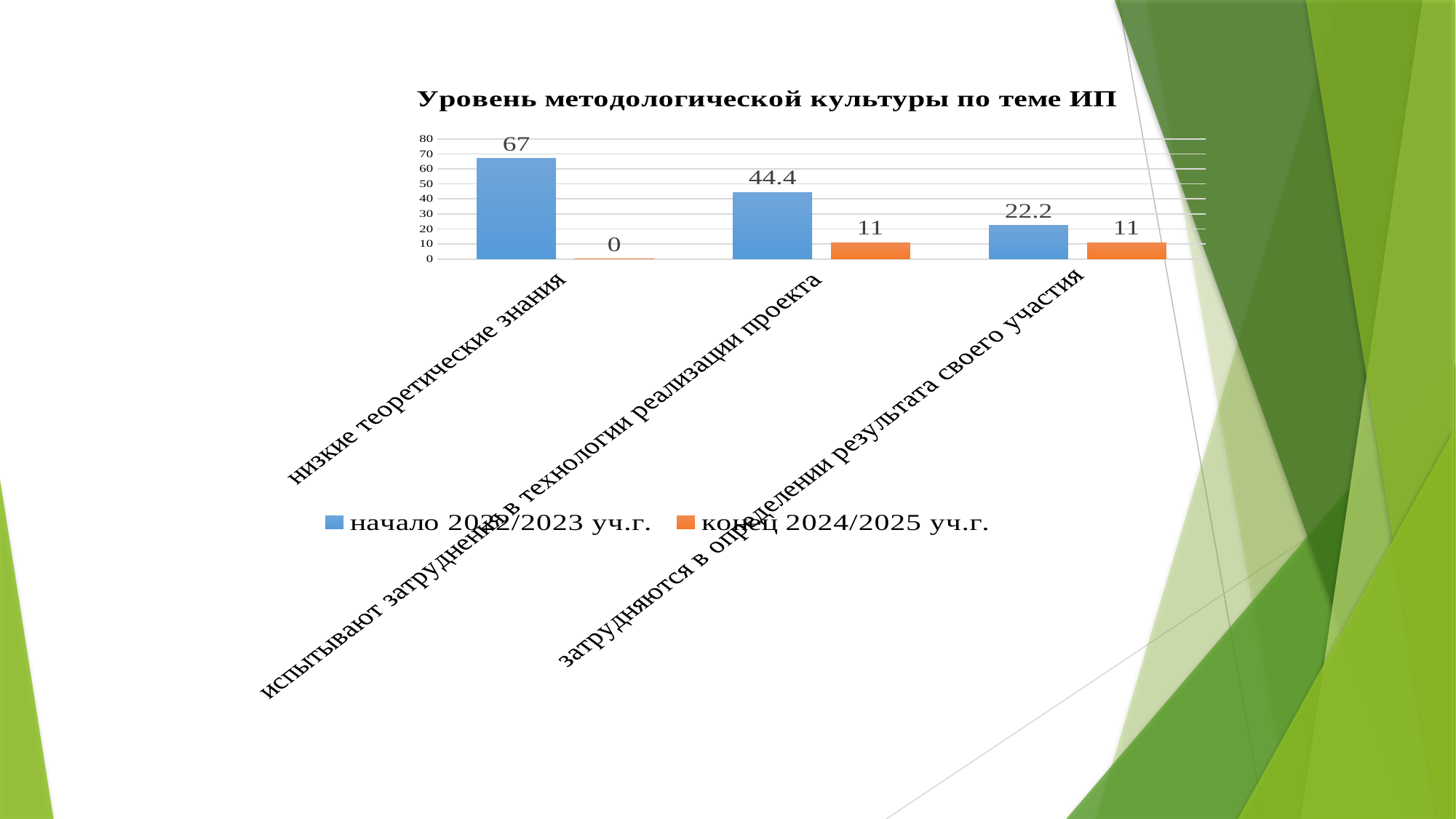
What is the value for 'низкие теоретические знания' in the 'конец 2024/2025 уч.г.' series? 0 Which is larger for 'затрудняются в определении результата своего участия': the 'начало 2022/2023 уч.г.' value or the 'конец 2024/2025 уч.г.' value? начало 2022/2023 уч.г. Which category has the lowest value in the 'конец 2024/2025 уч.г.' series? низкие теоретические знания How many series does the legend list? 2 What is the value for 'испытывают затруднения в технологии реализации проекта' in the 'начало 2022/2023 уч.г.' series? 44.4 What is the title of the chart? Уровень методологической культуры по теме ИП What is the value for 'затрудняются в определении результата своего участия' in the 'конец 2024/2025 уч.г.' series? 11 How many categories are shown on the x axis? 3 What is the difference between the 'начало 2022/2023 уч.г.' and 'конец 2024/2025 уч.г.' values for 'испытывают затруднения в технологии реализации проекта'? 33.4 What is the value for 'низкие теоретические знания' in the 'начало 2022/2023 уч.г.' series? 67 What type of chart is shown on the slide? bar chart Which category has the highest value in the 'начало 2022/2023 уч.г.' series? низкие теоретические знания